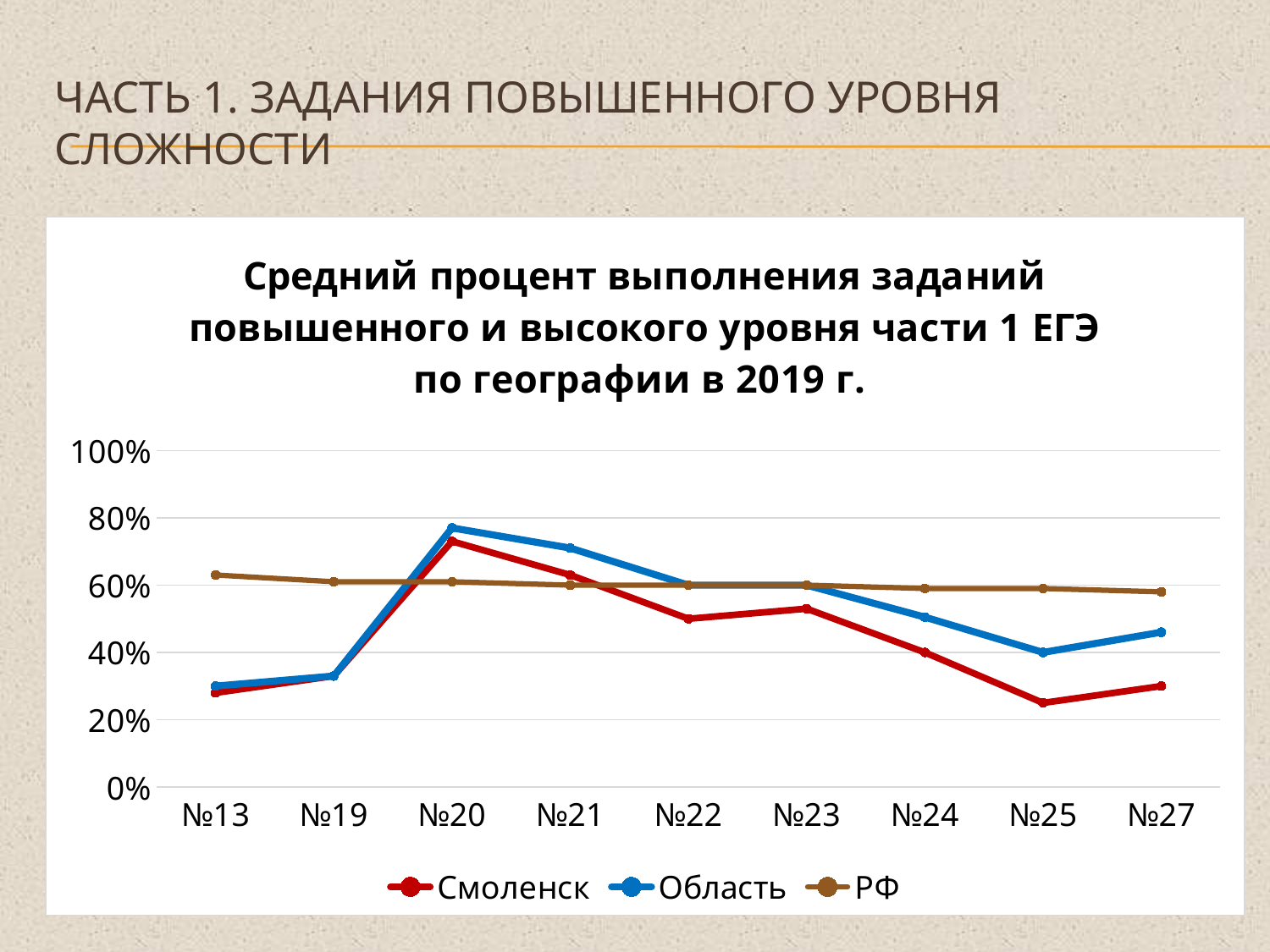
What kind of chart is shown on the slide? line chart Which series is shown in red in the legend? Смоленск Is the value for Смоленск at №25 greater or less than 40%? less At which task does the Смоленск series reach its highest value? №20 Is the value for Область at №20 greater or less than 60%? greater Is the value for РФ at №13 greater or less than 60%? greater How many task categories are shown on the x axis? 9 How many series does the legend list? 3 Does the Смоленск series rise or fall from №23 to №25? fall At №27, which series has the larger value, Смоленск or Область? Область At which task does the Смоленск series reach its lowest value? №25